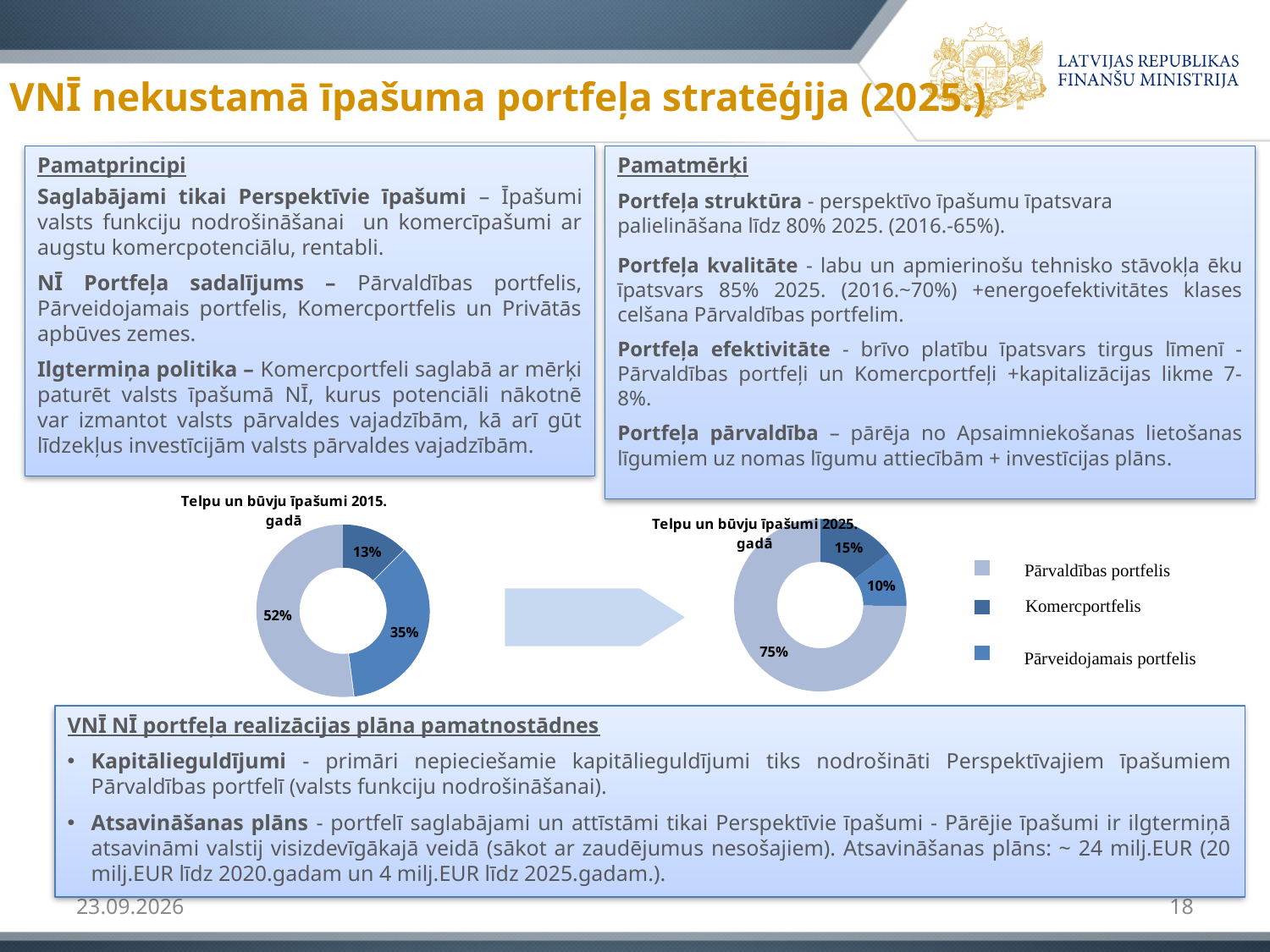
In the 'Telpu un būvju īpašumi 2025. gadā' chart, what is the smallest slice's value? 10% In the 'Telpu un būvju īpašumi 2025. gadā' chart, what share does Pārvaldības portfelis have? 75% In the 'Telpu un būvju īpašumi 2025. gadā' chart, what share does Pārveidojamais portfelis have? 10% How many entries does the legend next to the doughnut charts list? 3 In the 'Telpu un būvju īpašumi 2025. gadā' chart, what is the largest slice's value? 75% What is the difference between the Pārvaldības portfelis share in the 2025 chart (75%) and in the 2015 chart (52%)? 23 percentage points How many slices does the 'Telpu un būvju īpašumi 2015. gadā' chart have? 3 In the 'Telpu un būvju īpašumi 2015. gadā' chart, what is the largest slice's value? 52% In the 'Telpu un būvju īpašumi 2015. gadā' chart, what share does Komercportfelis have? 13% What kind of chart is used for 'Telpu un būvju īpašumi 2015. gadā'? doughnut chart In the 'Telpu un būvju īpašumi 2015. gadā' chart, what is the smallest slice's value? 13% Which is larger: the Komercportfelis share in the 2015 chart or in the 2025 chart? 2025 chart